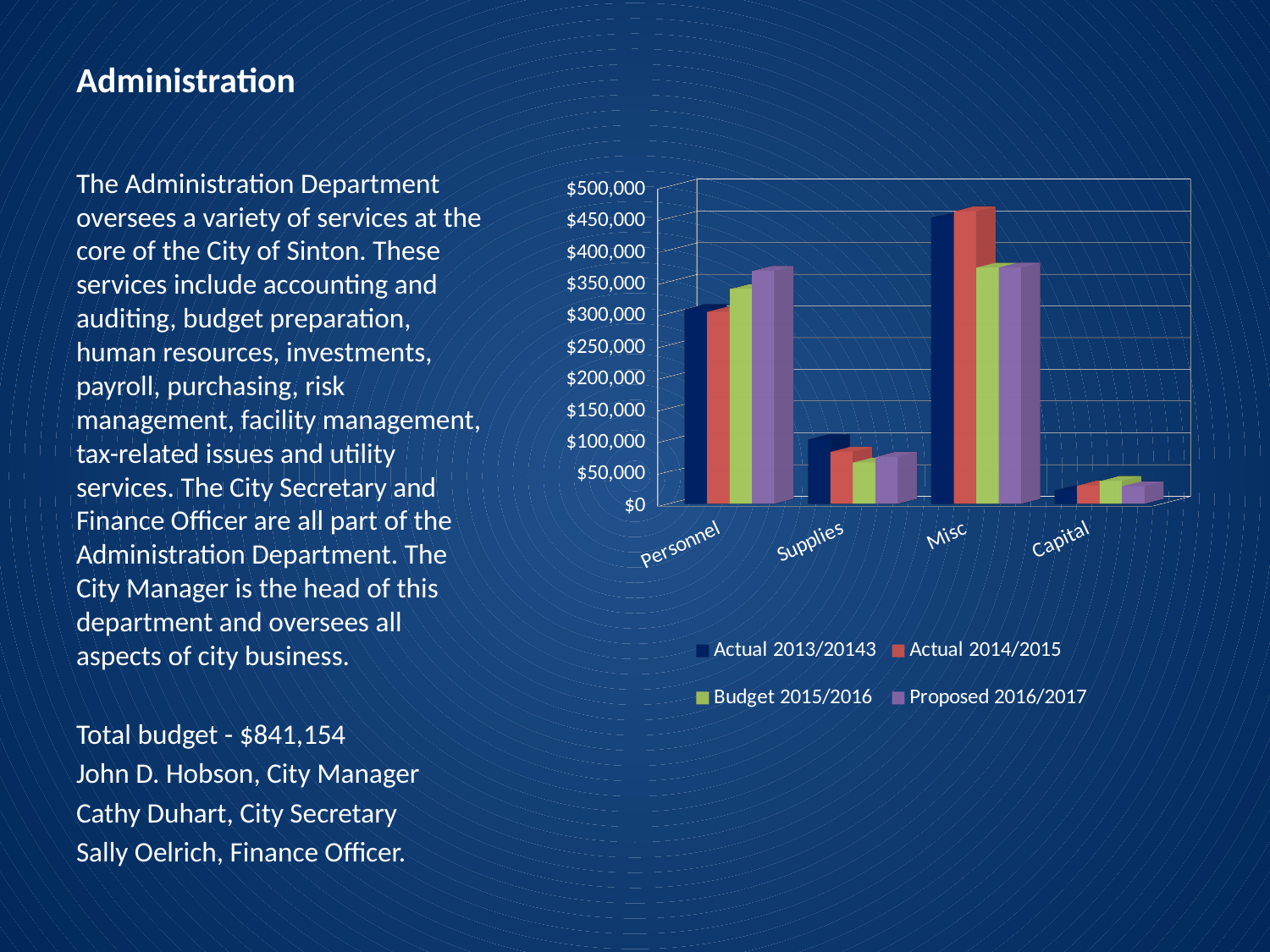
What colour represents the Budget 2015/2016 series in the chart? Green For Personnel, which is larger: the Actual 2013/20143 value or the Proposed 2016/2017 value? Proposed 2016/2017 How many series does the chart's legend list? 4 Is the Actual 2013/20143 value for Misc greater or less than $400,000? greater What kind of chart is shown on the slide? Bar chart Is the Proposed 2016/2017 value for Personnel greater or less than $350,000? greater Which category has the highest Actual 2014/2015 value? Misc Is the Budget 2015/2016 value for Supplies greater or less than $100,000? less How many categories are shown on the x axis of the chart? 4 For Misc, which is larger: the Actual 2014/2015 value or the Budget 2015/2016 value? Actual 2014/2015 Which category has the lowest Proposed 2016/2017 value? Capital